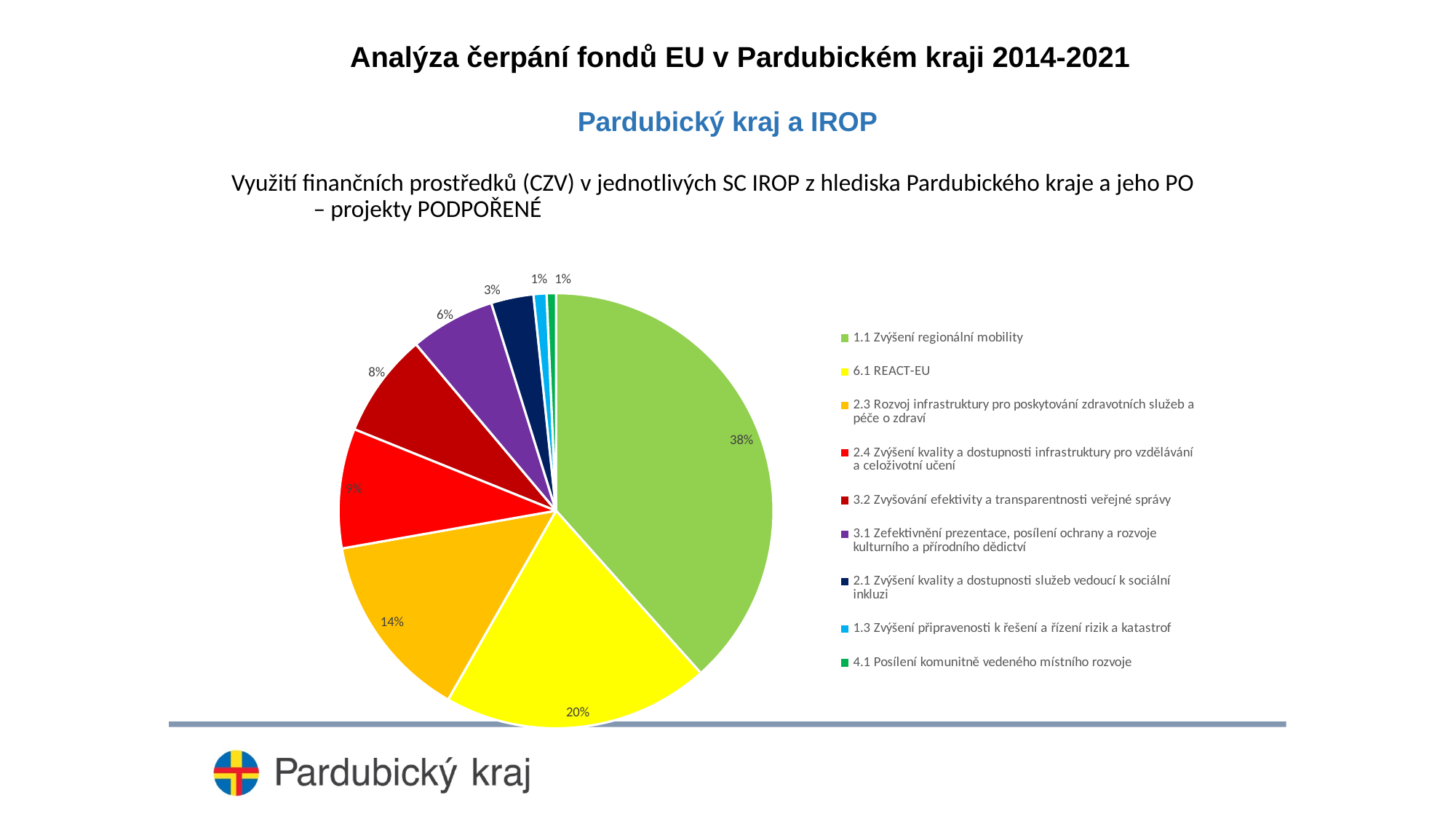
What share of the pie does "3.1 Zefektivnění prezentace, posílení ochrany a rozvoje kulturního a přírodního dědictví" have? 6% What is the difference in percentage points between the slices for "1.1 Zvýšení regionální mobility" and "6.1 REACT-EU"? 18 How many categories does the legend list? 9 What colour is the slice for "6.1 REACT-EU"? yellow Which category has the largest slice of the pie? 1.1 Zvýšení regionální mobility What kind of chart is shown on the slide? pie chart What share of the pie does "2.3 Rozvoj infrastruktury pro poskytování zdravotních služeb a péče o zdraví" have? 14% What share of the pie does "1.1 Zvýšení regionální mobility" have? 38% Which slice is larger: "2.4 Zvýšení kvality a dostupnosti infrastruktury pro vzdělávání a celoživotní učení" or "2.1 Zvýšení kvality a dostupnosti služeb vedoucí k sociální inkluzi"? 2.4 Zvýšení kvality a dostupnosti infrastruktury pro vzdělávání a celoživotní učení What is the title of the chart? Využití finančních prostředků (CZV) v jednotlivých SC IROP z hlediska Pardubického kraje a jeho PO – projekty PODPOŘENÉ